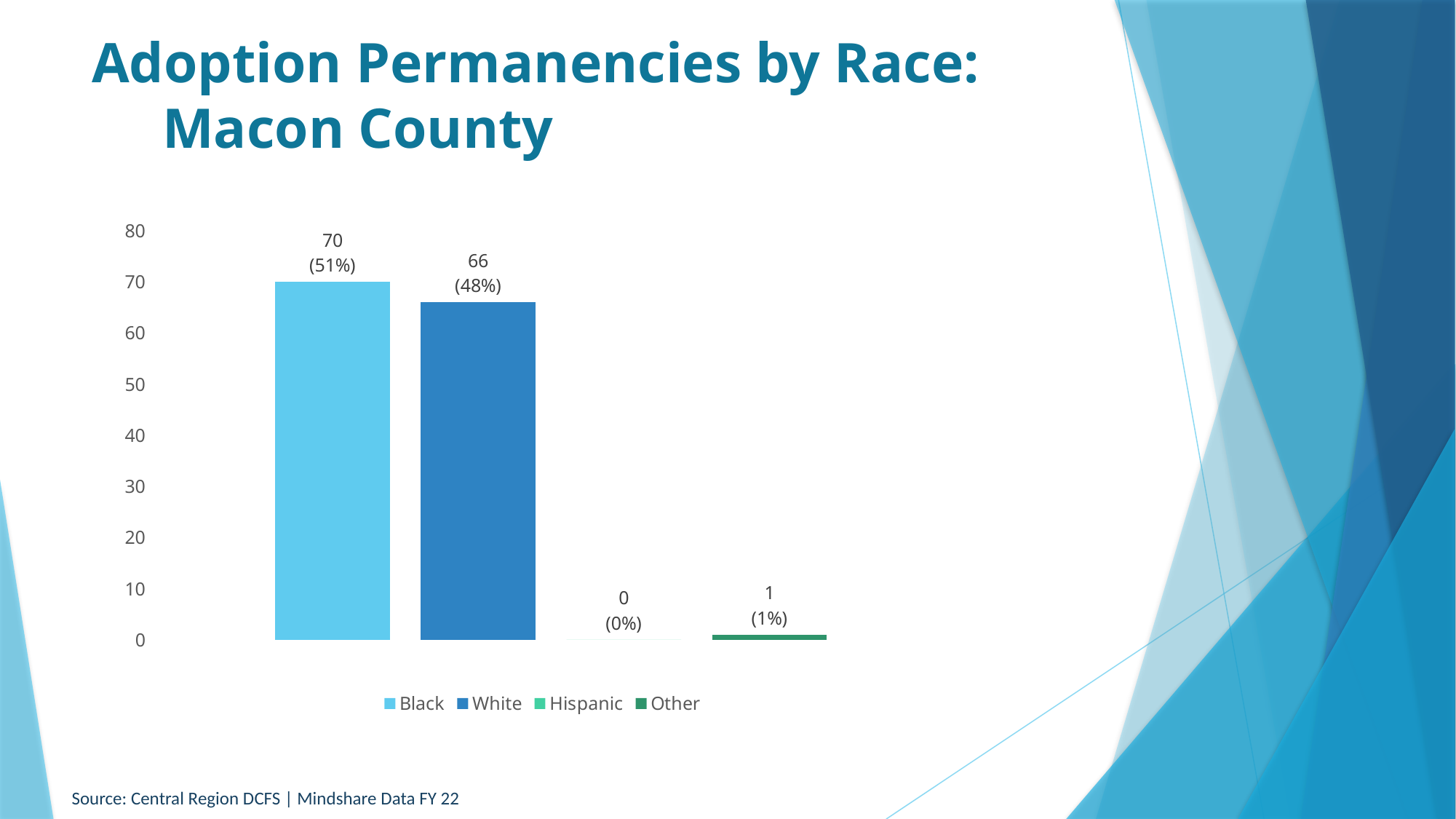
What is the difference between the Black and White values? 4 What kind of chart is shown on the slide? Bar chart Which race has the highest number of adoption permanencies? Black Is the value for White greater or less than 60? greater What is the value shown for Hispanic? 0 How many adoption permanencies are shown for Black in Macon County? 70 What is the source cited for the chart data? Central Region DCFS | Mindshare Data FY 22 Which race has the lowest number of adoption permanencies? Hispanic Which is larger, the value for White or the value for Other? White What percentage of adoption permanencies is shown for White? 48% How many race categories does the legend list? 4 What is the value shown for Other? 1